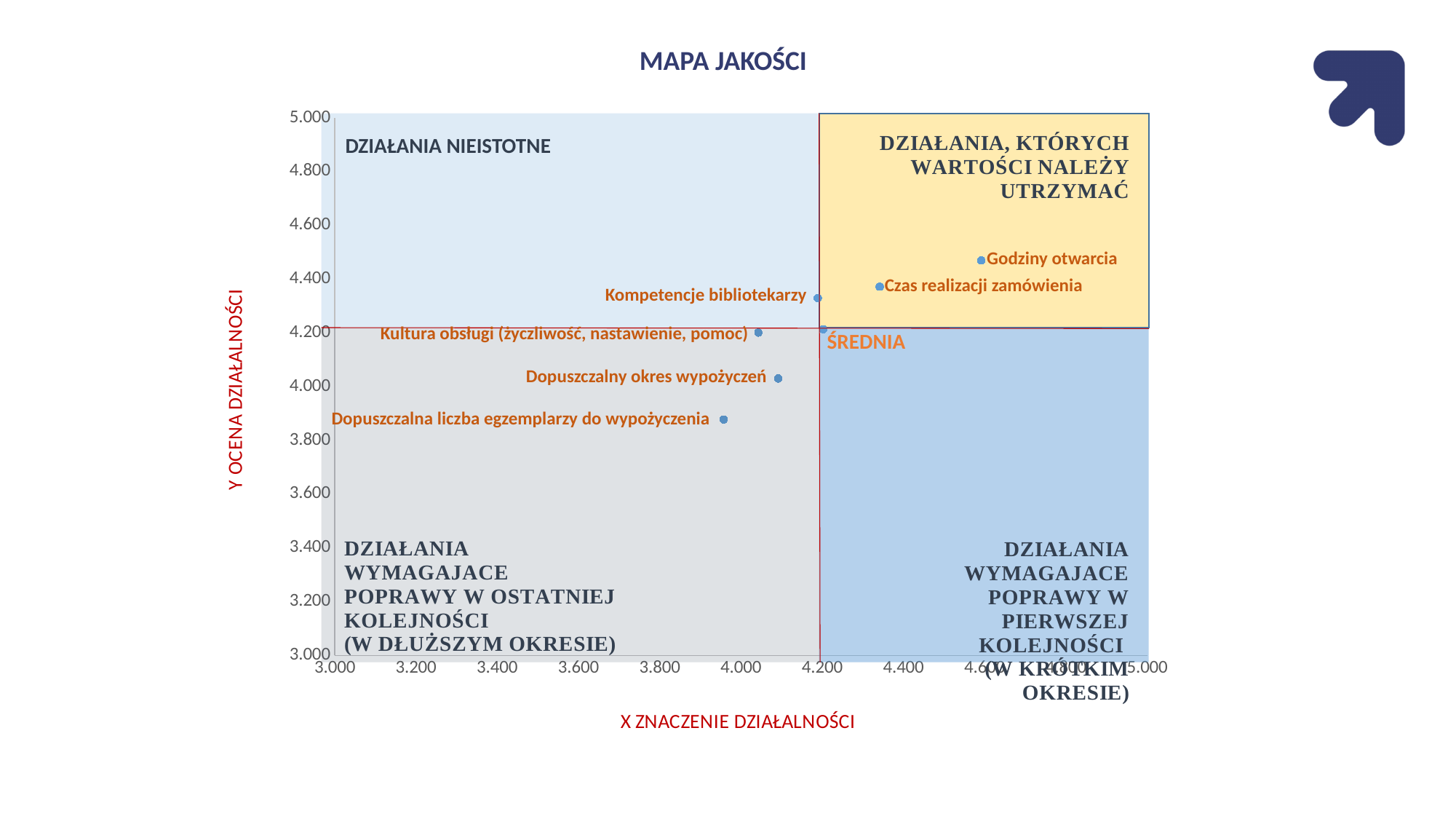
Which point has the lowest value on the x axis (ZNACZENIE DZIAŁALNOŚCI)? Dopuszczalna liczba egzemplarzy do wypożyczenia Is the y-axis value for Godziny otwarcia greater or less than 4.400? greater Which point has the highest value on the x axis (ZNACZENIE DZIAŁALNOŚCI)? Godziny otwarcia What is the title of the chart? MAPA JAKOŚCI Is the y-axis value for Dopuszczalna liczba egzemplarzy do wypożyczenia greater or less than 4.000? less Which point has the lowest value on the y axis (OCENA DZIAŁALNOŚCI)? Dopuszczalna liczba egzemplarzy do wypożyczenia Which point has the highest value on the y axis (OCENA DZIAŁALNOŚCI)? Godziny otwarcia Which has the higher y-axis value, Dopuszczalny okres wypożyczeń or Dopuszczalna liczba egzemplarzy do wypożyczenia? Dopuszczalny okres wypożyczeń How many data points are plotted on the chart? 7 What is the label of the x axis? X ZNACZENIE DZIAŁALNOŚCI Is the x-axis value for Czas realizacji zamówienia greater or less than 4.200? greater What kind of chart is shown on the slide? scatter chart